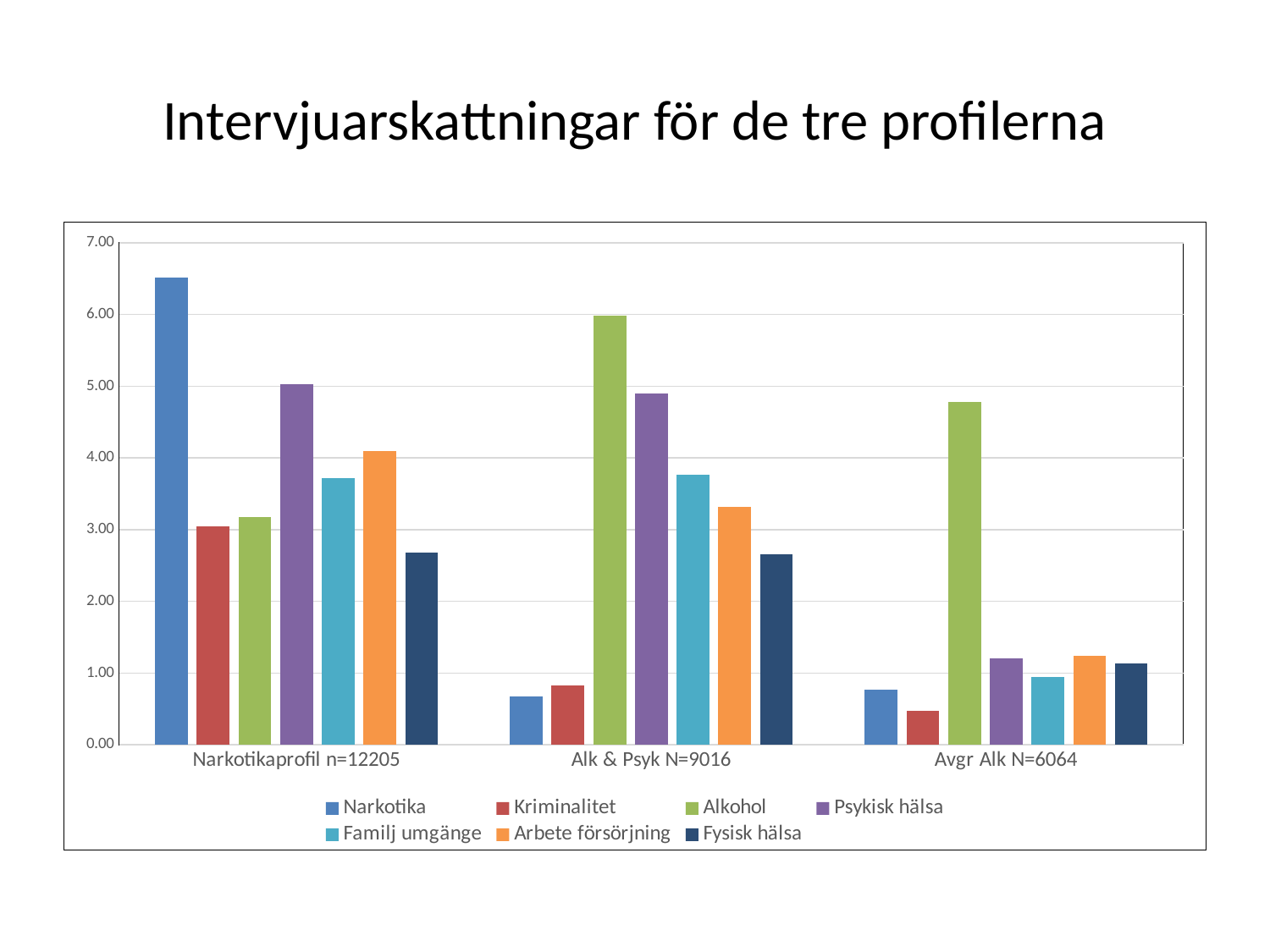
Which series has the highest bar in the Alk & Psyk N=9016 group? Alkohol Which group has the larger value for Arbete försörjning: Narkotikaprofil n=12205 or Alk & Psyk N=9016? Narkotikaprofil n=12205 Which series has the lowest bar in the Narkotikaprofil n=12205 group? Fysisk hälsa What kind of chart is shown on the slide? bar chart Which series has the highest bar in the Narkotikaprofil n=12205 group? Narkotika How many profile groups are shown on the x axis? 3 Is the value for Narkotika in the Narkotikaprofil n=12205 group greater or less than 6.00? greater What is the title of the slide? Intervjuarskattningar för de tre profilerna Is the value for Alkohol in the Avgr Alk N=6064 group greater or less than 5.00? less Is the value for Fysisk hälsa in the Alk & Psyk N=9016 group greater or less than 3.00? less Which series has the lowest bar in the Avgr Alk N=6064 group? Kriminalitet How many series does the legend list? 7